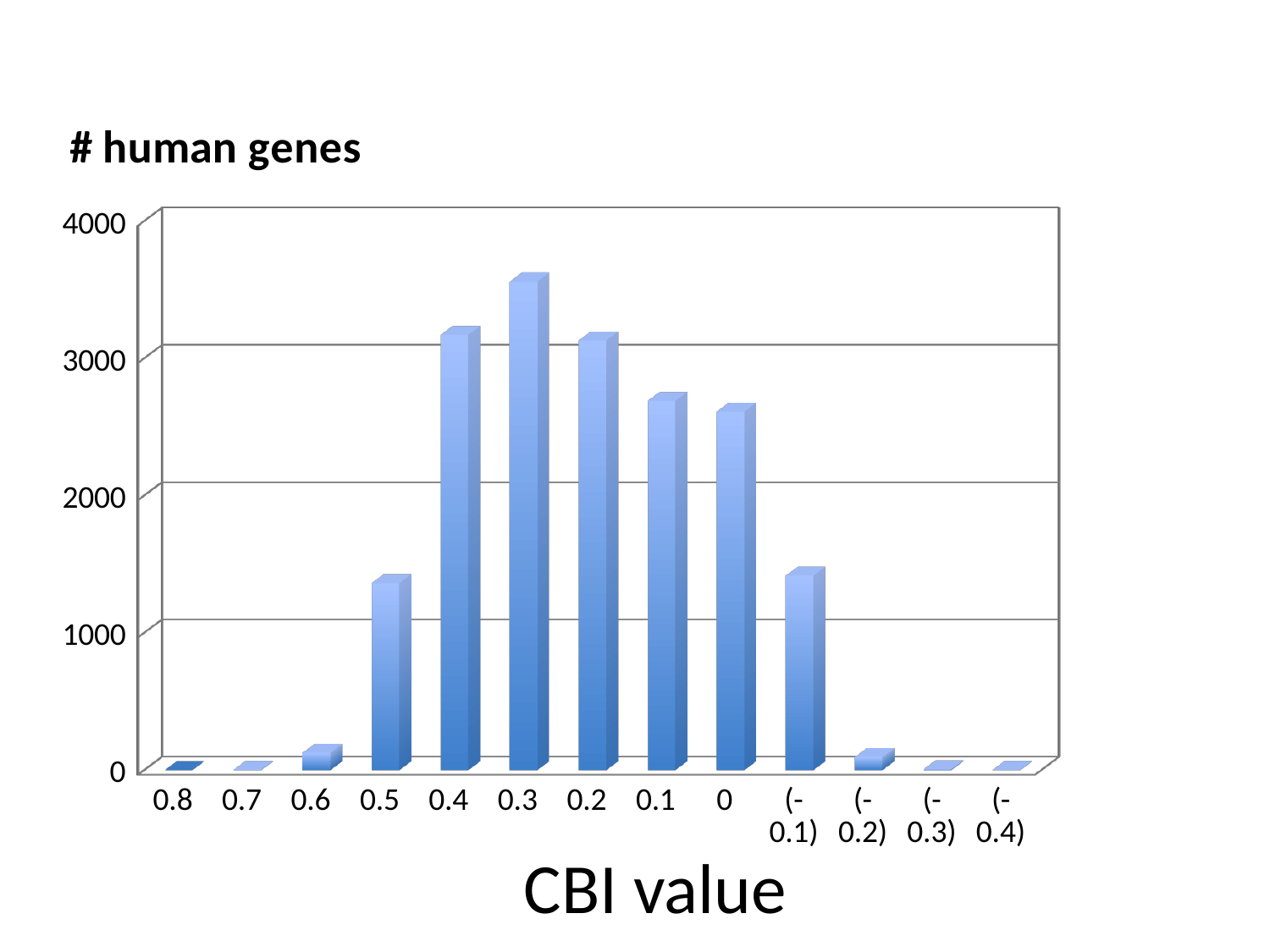
What is the title of the chart? # human genes What kind of chart is shown on the slide? bar chart What is the label of the x axis? CBI value Do the values rise or fall along the x axis from CBI value 0.3 to (-0.2)? fall Which has more human genes, CBI value 0.4 or CBI value 0.1? 0.4 Is the value for CBI value 0.3 greater or less than 3000? greater Is the value for CBI value 0 greater or less than 2000? greater How many CBI value categories are shown on the x axis? 13 Is the value for CBI value 0.6 greater or less than 1000? less Which CBI value has the highest number of human genes? 0.3